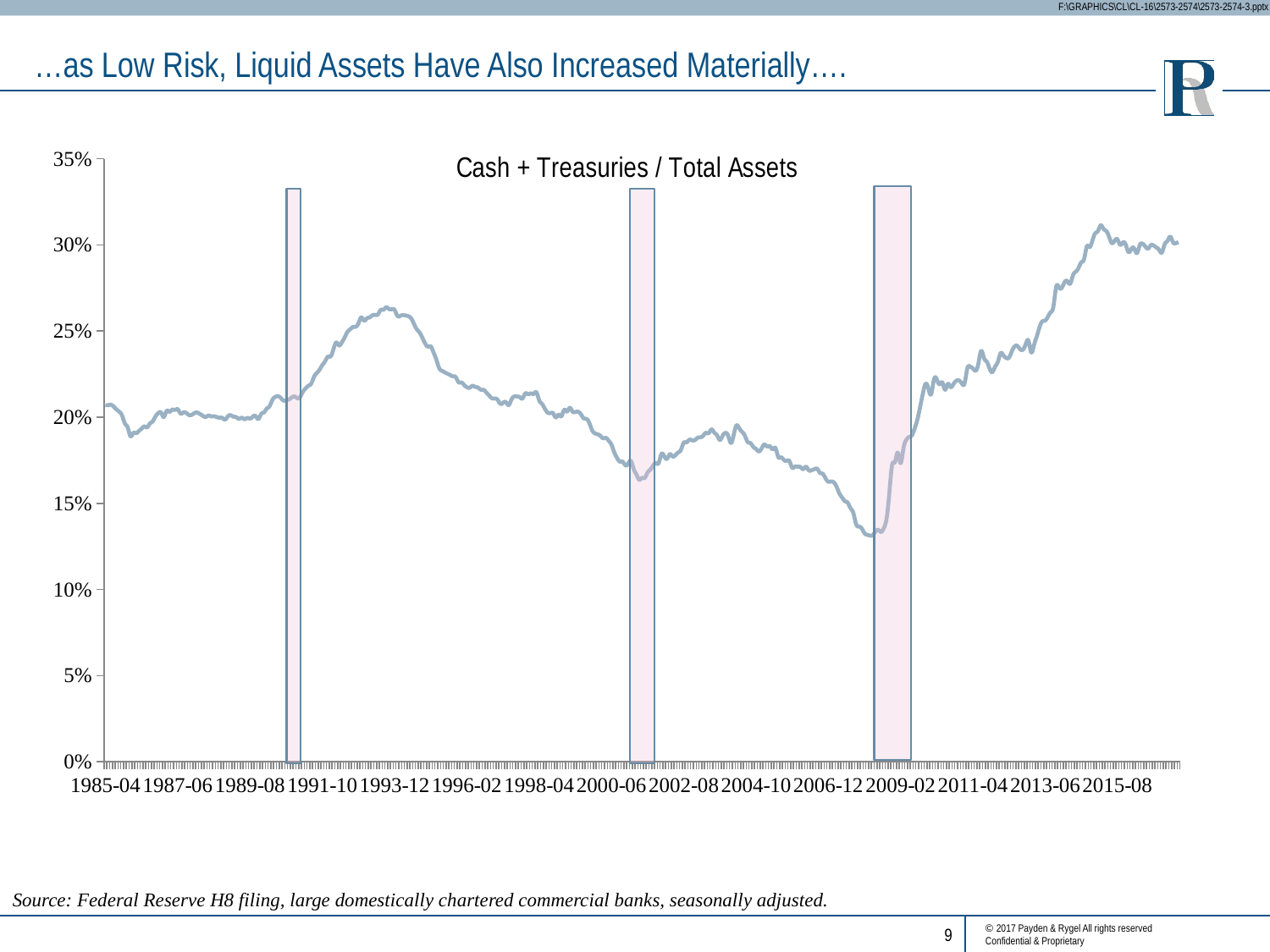
Is the value for 1985-04 greater or less than 15%? greater Is the lowest value of the series greater or less than 15%? less Is the value for 2006-12 greater or less than 20%? less Does the series rise or fall between 2009-02 and 2015-08? rise Which is larger, the value at 2015-08 or the value at 1985-04? 2015-08 What kind of chart is shown on the slide? line chart How many shaded vertical bands are drawn on the chart? 3 What is the title of the chart? Cash + Treasuries / Total Assets Does the series rise or fall between 1993-12 and 2000-06? fall